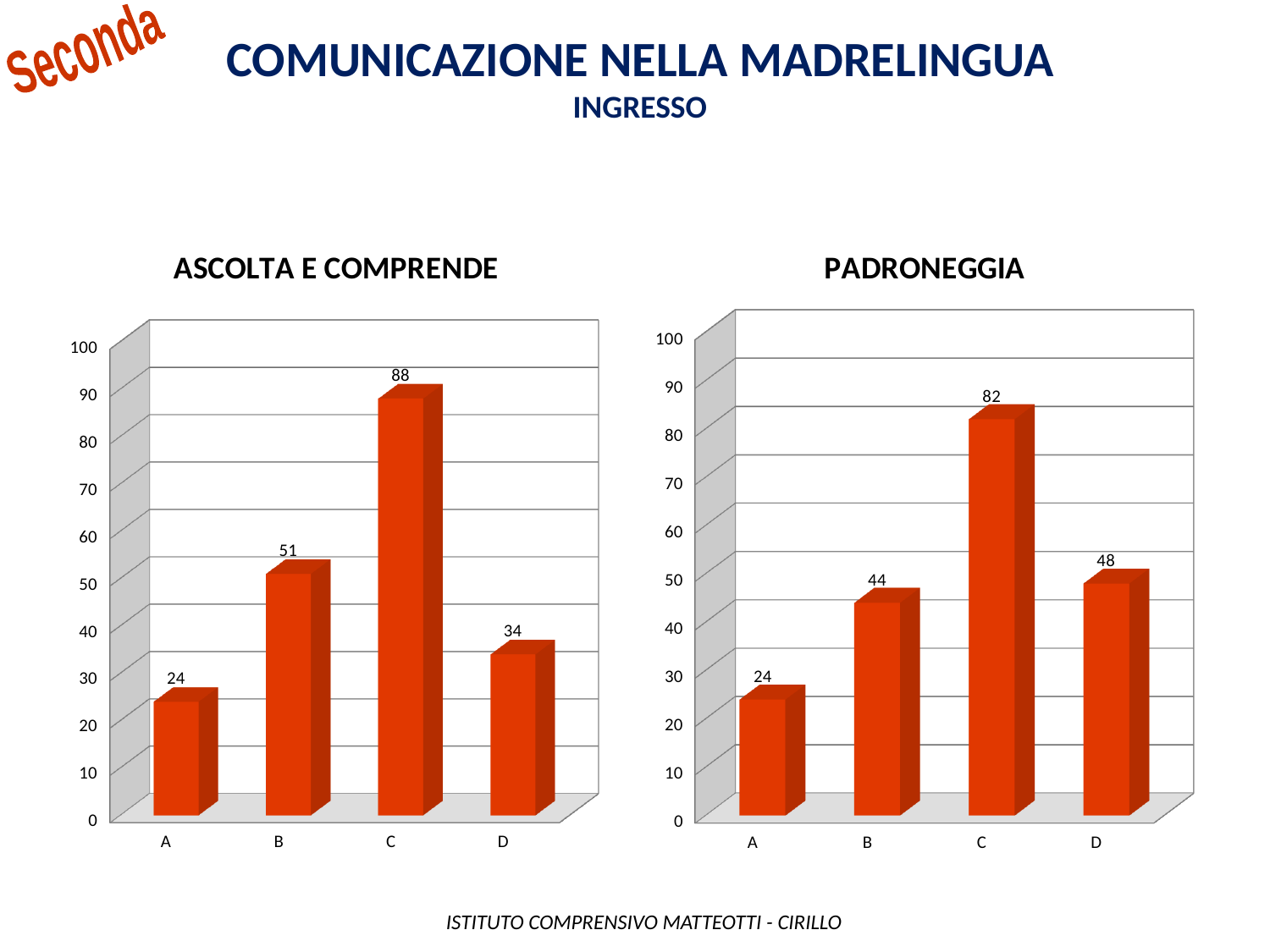
In the ASCOLTA E COMPRENDE chart, what is the difference between the values for C and B? 37 In the PADRONEGGIA chart, what is the value for category B? 44 In the ASCOLTA E COMPRENDE chart, what is the value for category D? 34 In the ASCOLTA E COMPRENDE chart, which category has the lowest value? A How many categories are shown in the PADRONEGGIA chart? 4 In the ASCOLTA E COMPRENDE chart, which is larger, the value for B or the value for D? B What is the title of the chart on the right side of the slide? PADRONEGGIA In the PADRONEGGIA chart, which category has the highest value? C In the PADRONEGGIA chart, what is the difference between the values for D and A? 24 In the ASCOLTA E COMPRENDE chart, what is the value for category C? 88 In the PADRONEGGIA chart, is the value for C greater or less than 70? greater What kind of chart is the ASCOLTA E COMPRENDE chart? bar chart